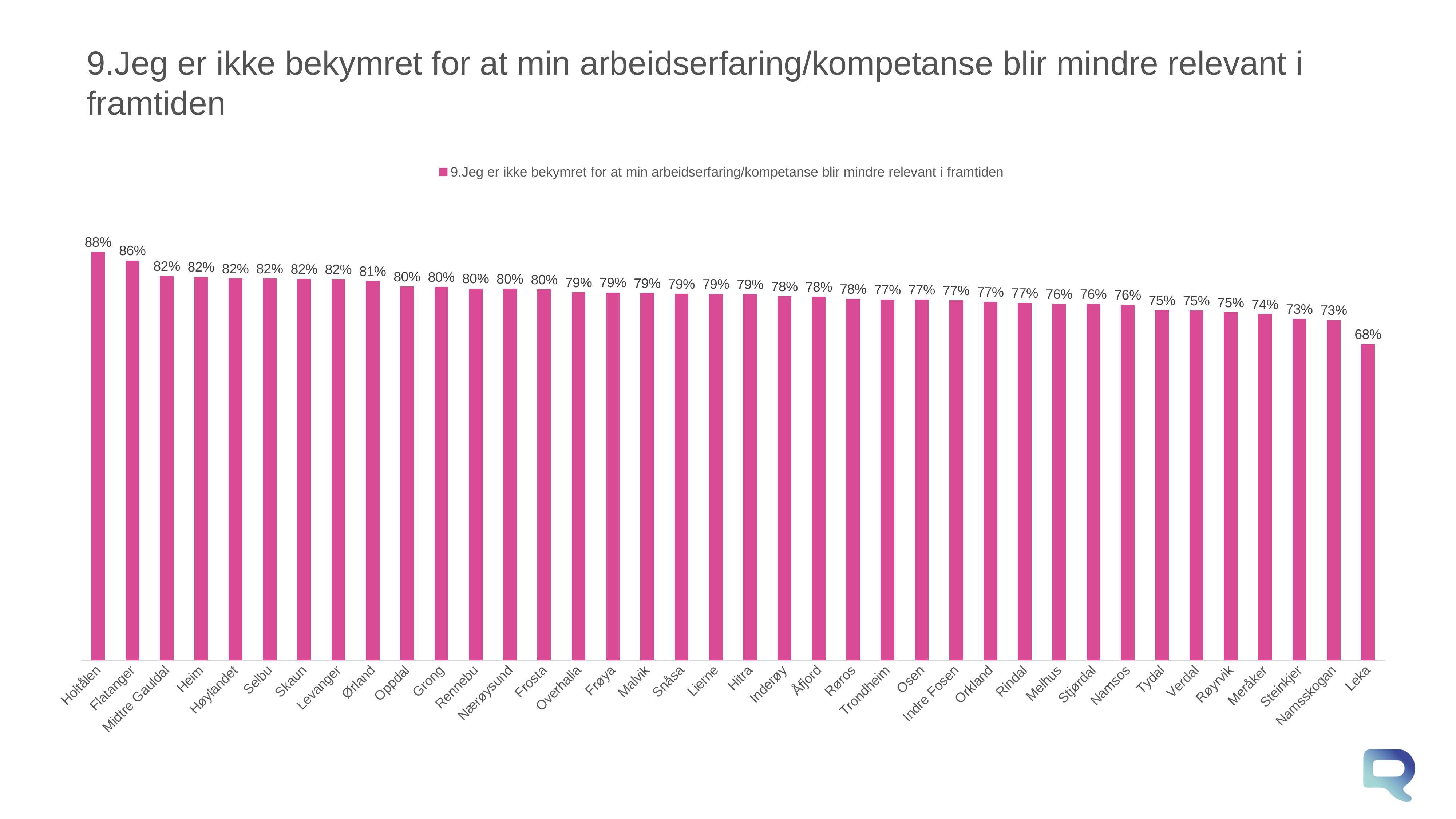
What is the difference between the values for Holtålen and Leka? 20% What is the value for Trondheim? 77% What is the value for Leka? 68% What kind of chart is shown on the slide? Bar chart What is the value for Steinkjer? 73% What is the difference between the values for Flatanger and Meråker? 12% Do the values rise or fall from left to right along the x axis? Fall Which category has the highest value? Holtålen Which category has the lowest value? Leka What is the value for Holtålen? 88% How many categories are shown on the x axis? 38 Which has a larger value, Ørland or Namsos? Ørland